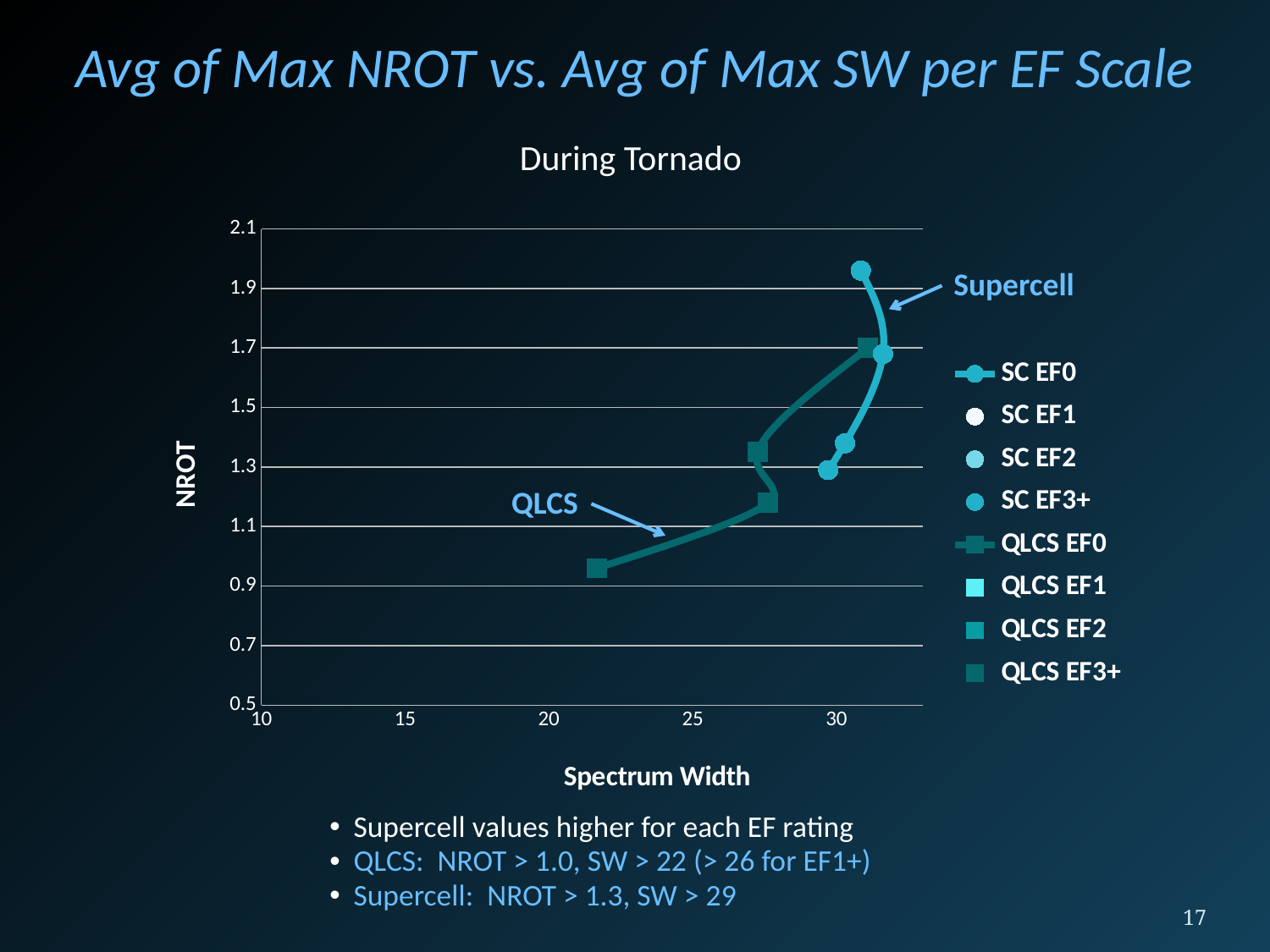
Is the Spectrum Width of the lowest point on the QLCS curve greater or less than 20? greater Is the NROT value of the highest point on the Supercell curve greater or less than 1.9? greater Is the NROT value of the lowest point on the QLCS curve greater or less than 1.1? less What is the label of the y axis? NROT Which curve reaches the highest NROT value, Supercell or QLCS? Supercell How many data points are plotted on the Supercell curve? 4 What is the label of the x axis? Spectrum Width How many entries does the chart legend list? 8 Which curve contains the point with the lowest NROT value, Supercell or QLCS? QLCS How many data points are plotted on the QLCS curve? 4 What kind of chart is shown on the slide? line chart